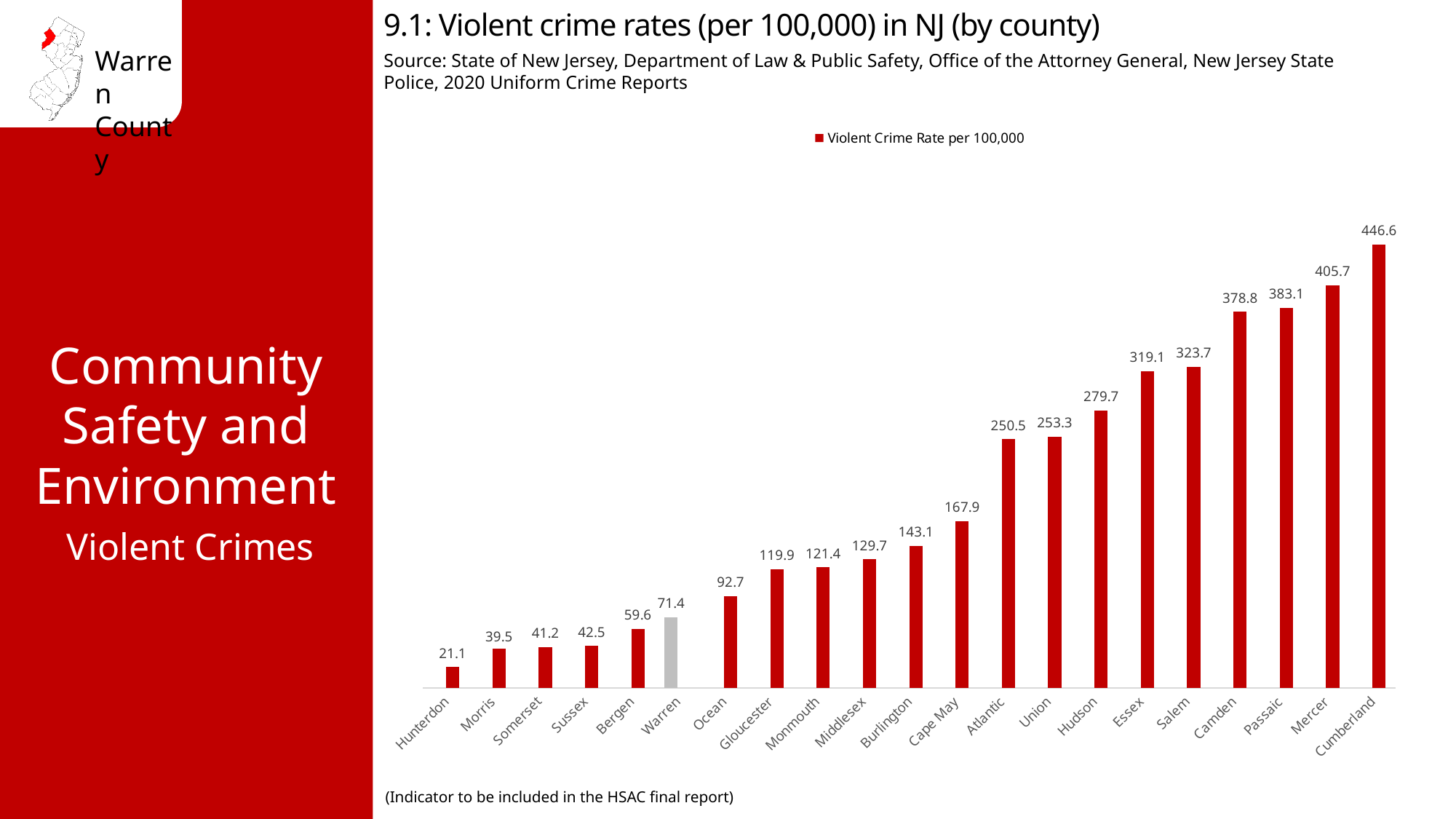
What is the violent crime rate per 100,000 for Hudson County? 279.7 Do the values rise or fall from left to right along the x axis? Rise Which county has the highest violent crime rate? Cumberland Which county has a higher violent crime rate, Essex or Atlantic? Essex What is the difference between the violent crime rates of Cumberland and Hunterdon? 425.5 What is the difference between the violent crime rates of Warren and Bergen? 11.8 How many counties are shown on the chart? 21 What is the violent crime rate per 100,000 for Warren County? 71.4 Which county has the lowest violent crime rate? Hunterdon How many series does the legend list? 1 What is the violent crime rate per 100,000 for Cape May County? 167.9 What type of chart is shown on the slide? Bar chart